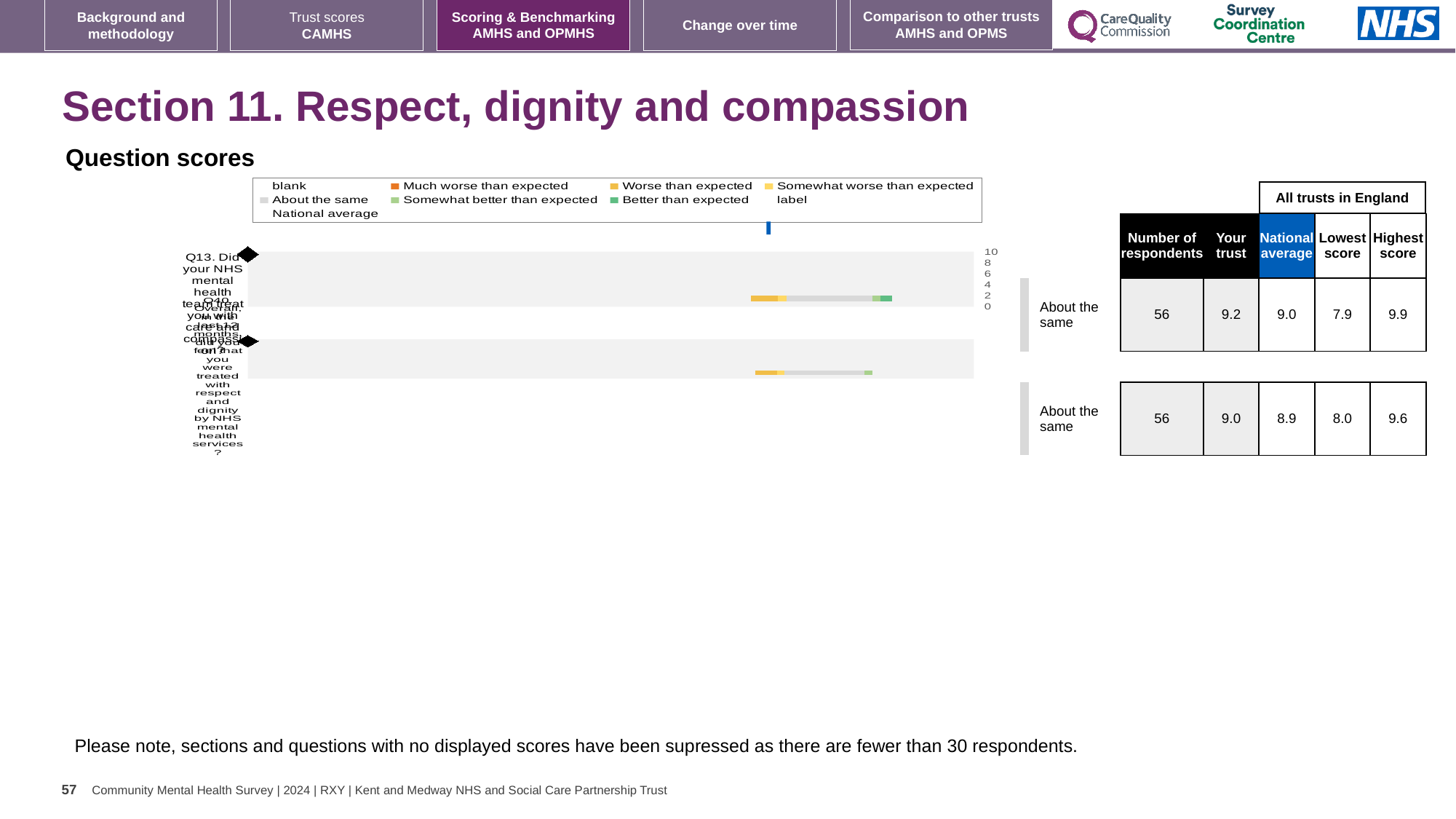
What is the national average score for Q10 (respect and dignity)? 8.9 What is the "Your trust" score for Q13 (care and compassion)? 9.2 What benchmark category is shown for Q10? About the same What is the difference between the highest score and the lowest score for Q13? 2.0 What is the lowest score across all trusts in England for Q13? 7.9 Which question has the higher "Your trust" score, Q13 or Q10? Q13 What is the title of the chart on this slide? Question scores What kind of chart is shown under "Question scores"? bar chart How many respondents answered Q13? 56 How many questions are plotted in the Question scores chart? 2 By how much does the "Your trust" score for Q13 exceed the national average for Q13? 0.2 What is the highest score across all trusts in England for Q10? 9.6